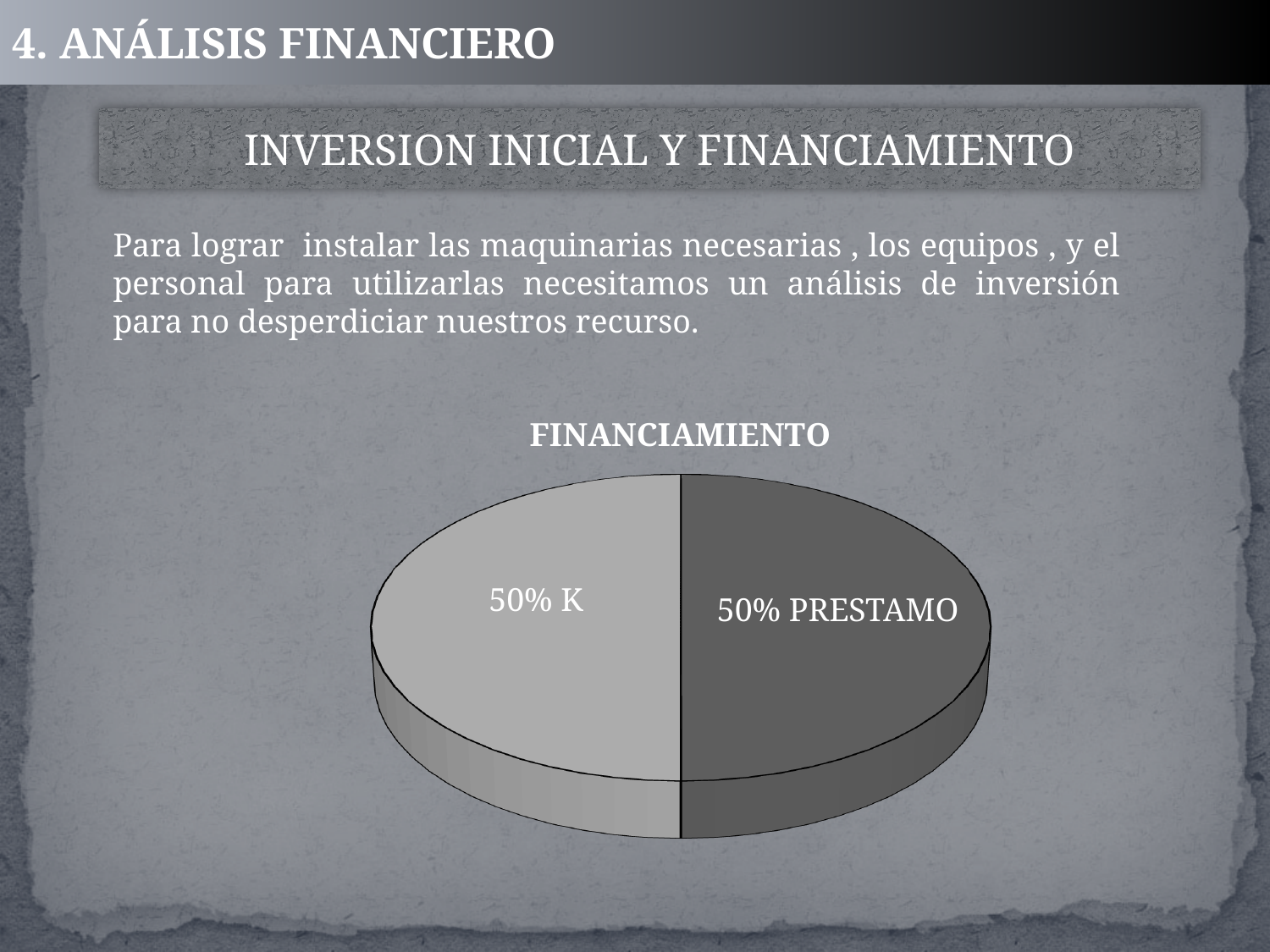
Which slice of the pie is shown in the darker grey colour? PRESTAMO What are the two categories shown in the pie chart? K and PRESTAMO What kind of chart is shown on the slide? pie chart What is the title of the chart? FINANCIAMIENTO What is the total of the two slices shown in the pie chart? 100% How many slices does the pie chart have? 2 What share of the pie does the PRESTAMO slice represent? 50% What is the difference between the K share and the PRESTAMO share? 0% What share of the pie does the K slice represent? 50%